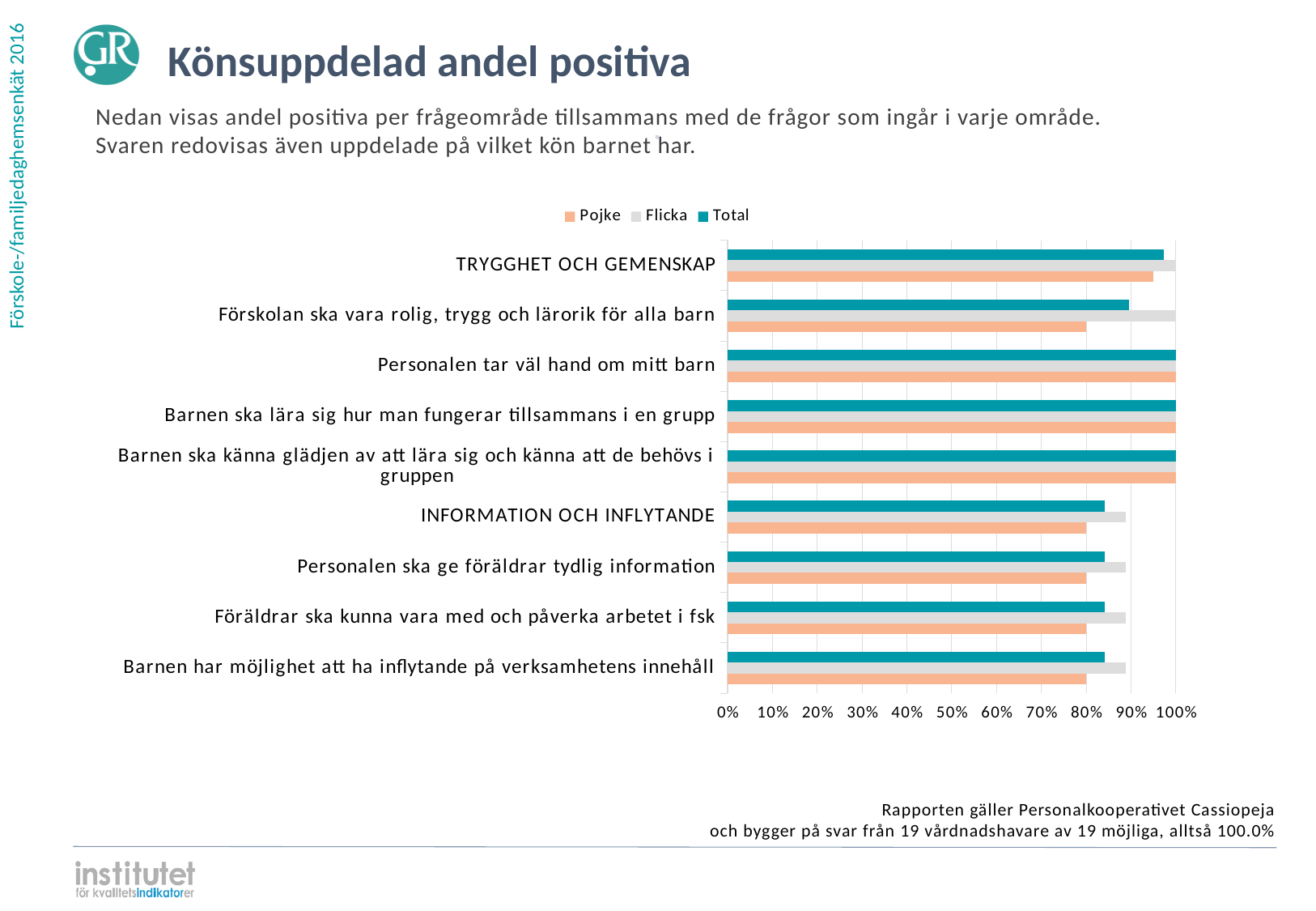
For "Förskolan ska vara rolig, trygg och lärorik för alla barn", which is larger: the Pojke value or the Flicka value? Flicka What is the title of the slide containing the chart? Könsuppdelad andel positiva What is the Total value for "Personalen tar väl hand om mitt barn"? 100% What is the Flicka value for "Barnen ska lära sig hur man fungerar tillsammans i en grupp"? 100% How many series does the legend list? 3 What kind of chart is shown on the slide? bar chart What is the Pojke value for "Förskolan ska vara rolig, trygg och lärorik för alla barn"? 80% How many categories are plotted on the y axis of the chart? 9 Is the Total value for TRYGGHET OCH GEMENSKAP greater or less than 90%? greater Is the Flicka value for "Personalen ska ge föräldrar tydlig information" greater or less than 80%? greater Which has the larger Total value: TRYGGHET OCH GEMENSKAP or INFORMATION OCH INFLYTANDE? TRYGGHET OCH GEMENSKAP Is the Pojke value for INFORMATION OCH INFLYTANDE greater or less than 90%? less